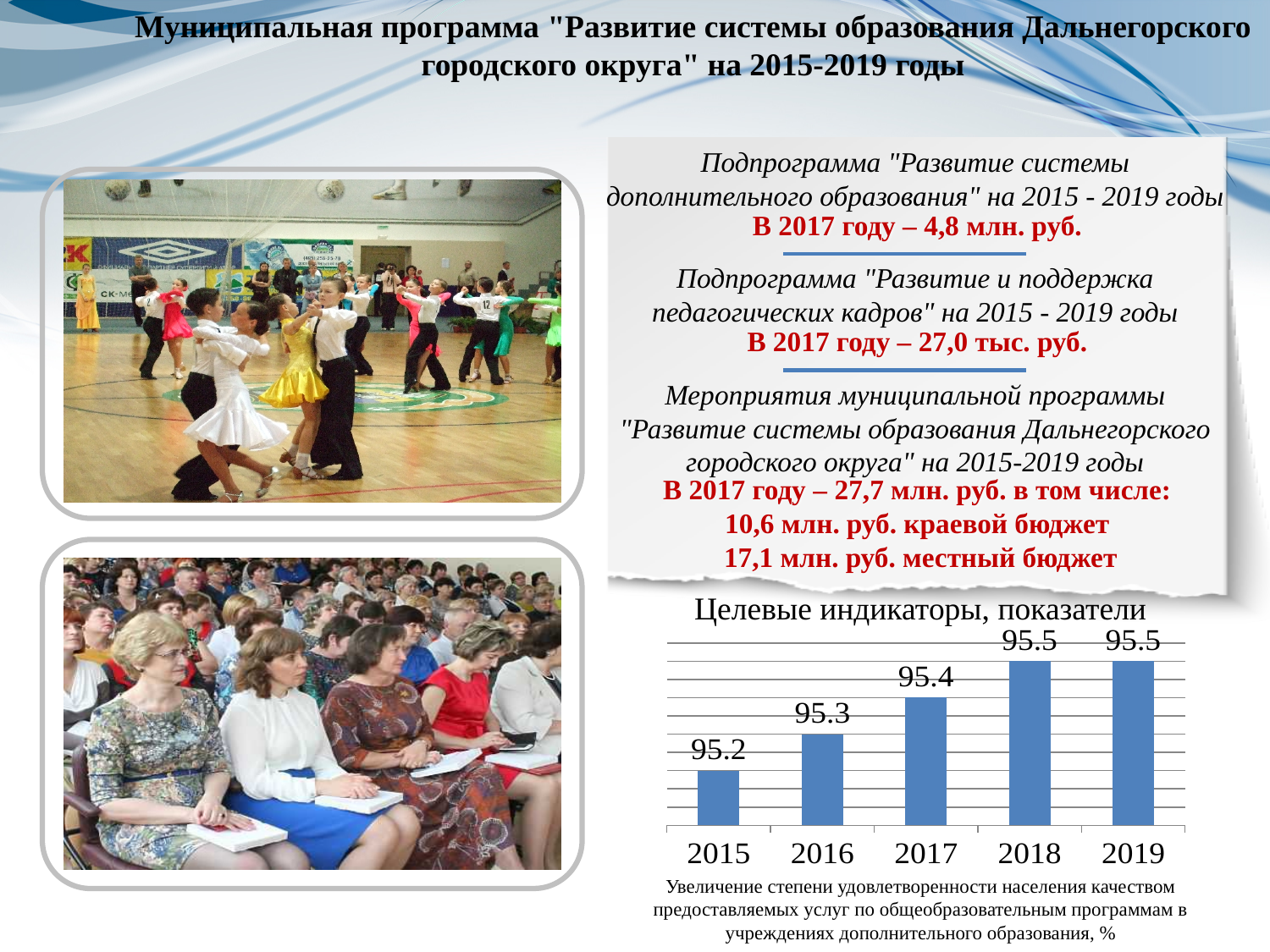
What kind of chart is shown on the slide? bar chart What colour are the bars in the chart? blue How many years are shown on the x axis of the chart? 5 What is the value for 2019 in the chart? 95.5 What is the title of the chart? Целевые индикаторы, показатели Do the values rise or fall from 2015 to 2019? rise What is the difference between the values for 2017 and 2016? 0.1 Which is larger, the value for 2016 or the value for 2017? 2017 What is the difference between the values for 2018 and 2015? 0.3 Which year has the lowest value in the chart? 2015 What is the value for 2017 in the chart? 95.4 What is the value for 2015 in the chart 'Целевые индикаторы, показатели'? 95.2